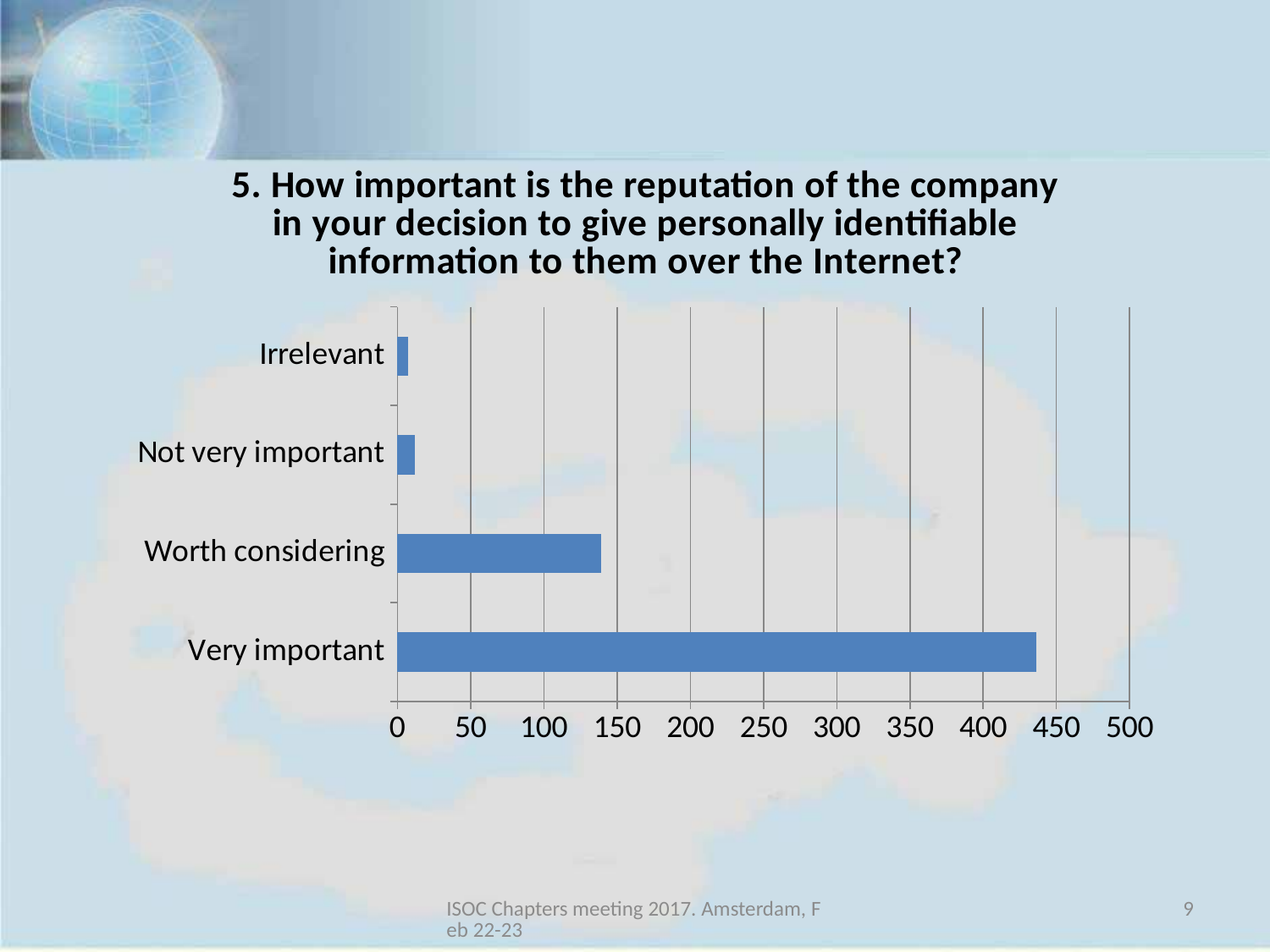
Is the value for Irrelevant greater or less than 50? less Is the value for Very important greater or less than 400? greater Is the value for Worth considering greater or less than 100? greater How many categories are shown on the chart? 4 What kind of chart is shown on the slide? bar chart Which is larger, the value for Worth considering or the value for Not very important? Worth considering Which category has the highest value? Very important Which is larger, the value for Very important or the value for Worth considering? Very important What is the highest value shown on the horizontal axis of the chart? 500